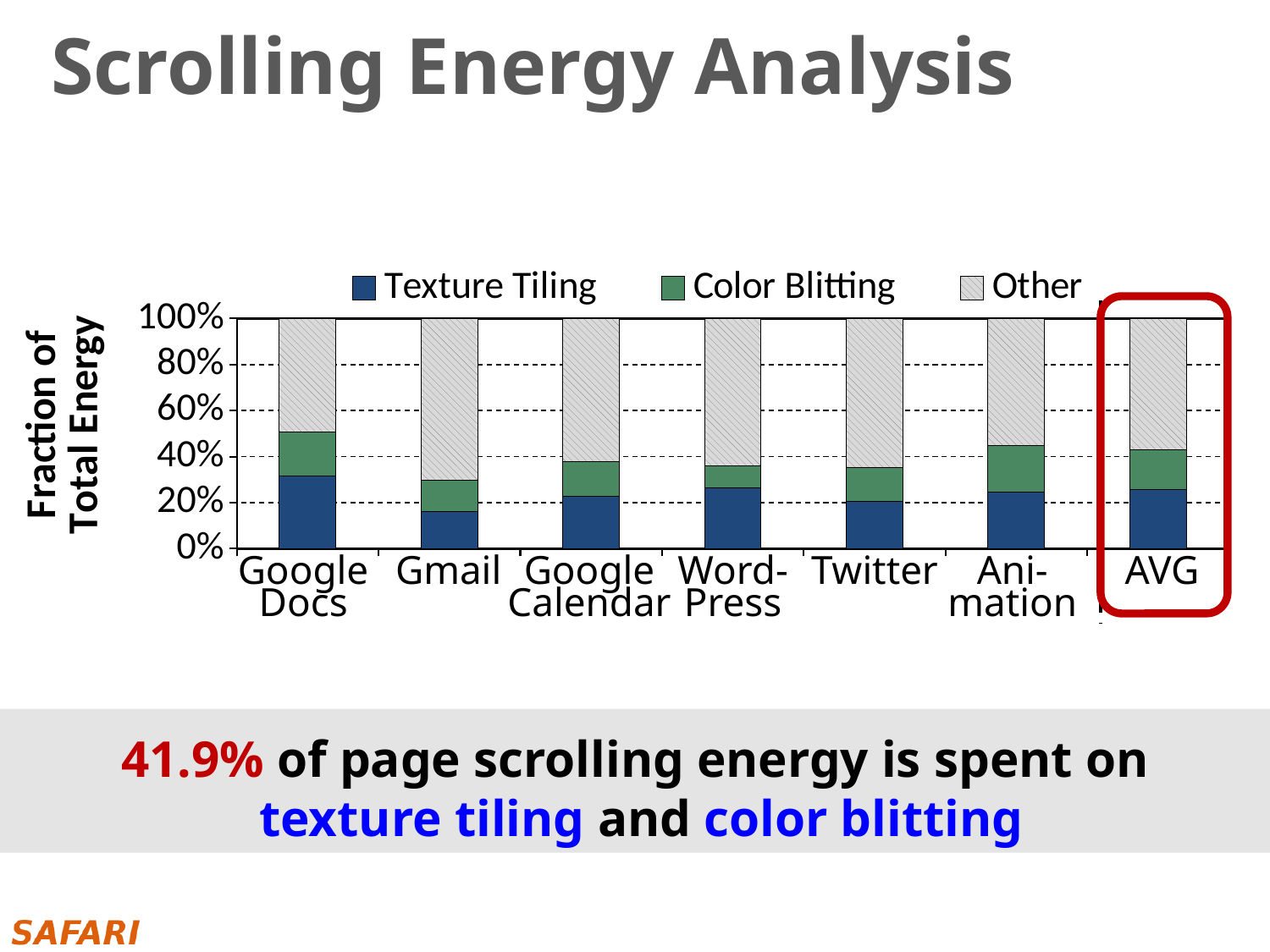
Which category on the x axis is highlighted with a red box? AVG Which category has the highest Texture Tiling fraction? Google Docs Is the Other fraction for Gmail greater or less than 60%? greater What kind of chart is shown on the slide? stacked bar chart Is the Texture Tiling value for Google Docs greater or less than 20%? greater What is the label on the y axis of the chart? Fraction of Total Energy How many series does the chart's legend list? 3 Which category has the lowest Texture Tiling fraction? Gmail How many categories are shown along the x axis of the chart? 7 What is the total height of the stacked bar for AVG? 100% Is the Texture Tiling value for Gmail greater or less than 20%? less Which has a larger Texture Tiling fraction, Google Docs or Gmail? Google Docs